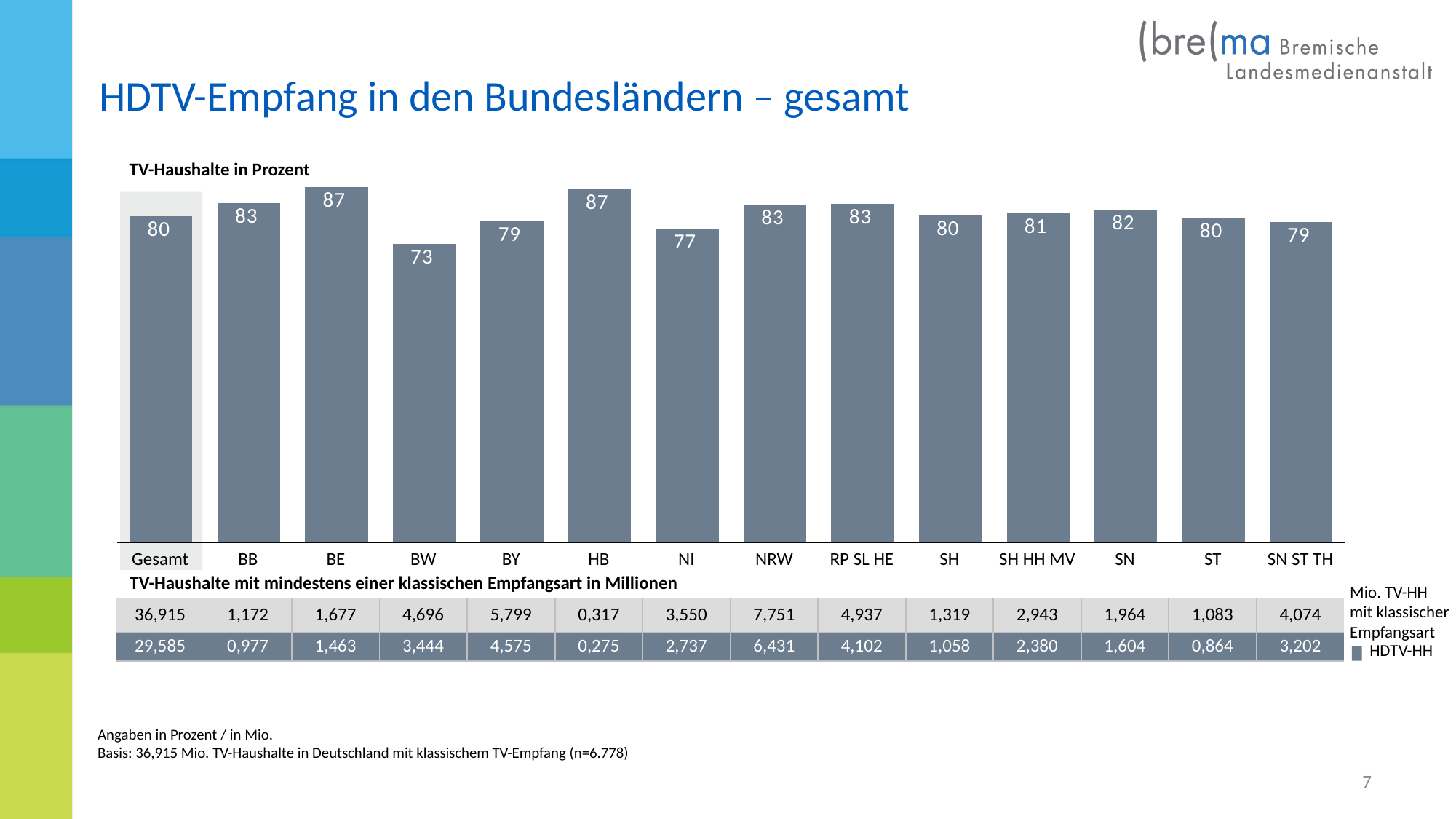
In the table below the chart, what is the number of HDTV-HH (in millions) for NRW? 6,431 What kind of chart is shown on the slide? bar chart In the table below the chart, what is the number of TV-HH mit klassischer Empfangsart (in millions) for HB? 0,317 Which category has the lowest value in the bar chart? BW What is the label above the bar chart describing the unit of the bars? TV-Haushalte in Prozent What is the value for BW in the bar chart? 73 What is the value for NI in the bar chart? 77 What is the difference between the values for HB and NI in the bar chart? 10 Which is larger in the bar chart, the value for SN or the value for BY? SN How many categories are shown on the x axis of the bar chart? 14 What is the difference between the values for BE and BW in the bar chart? 14 What is the value for Gesamt in the bar chart? 80